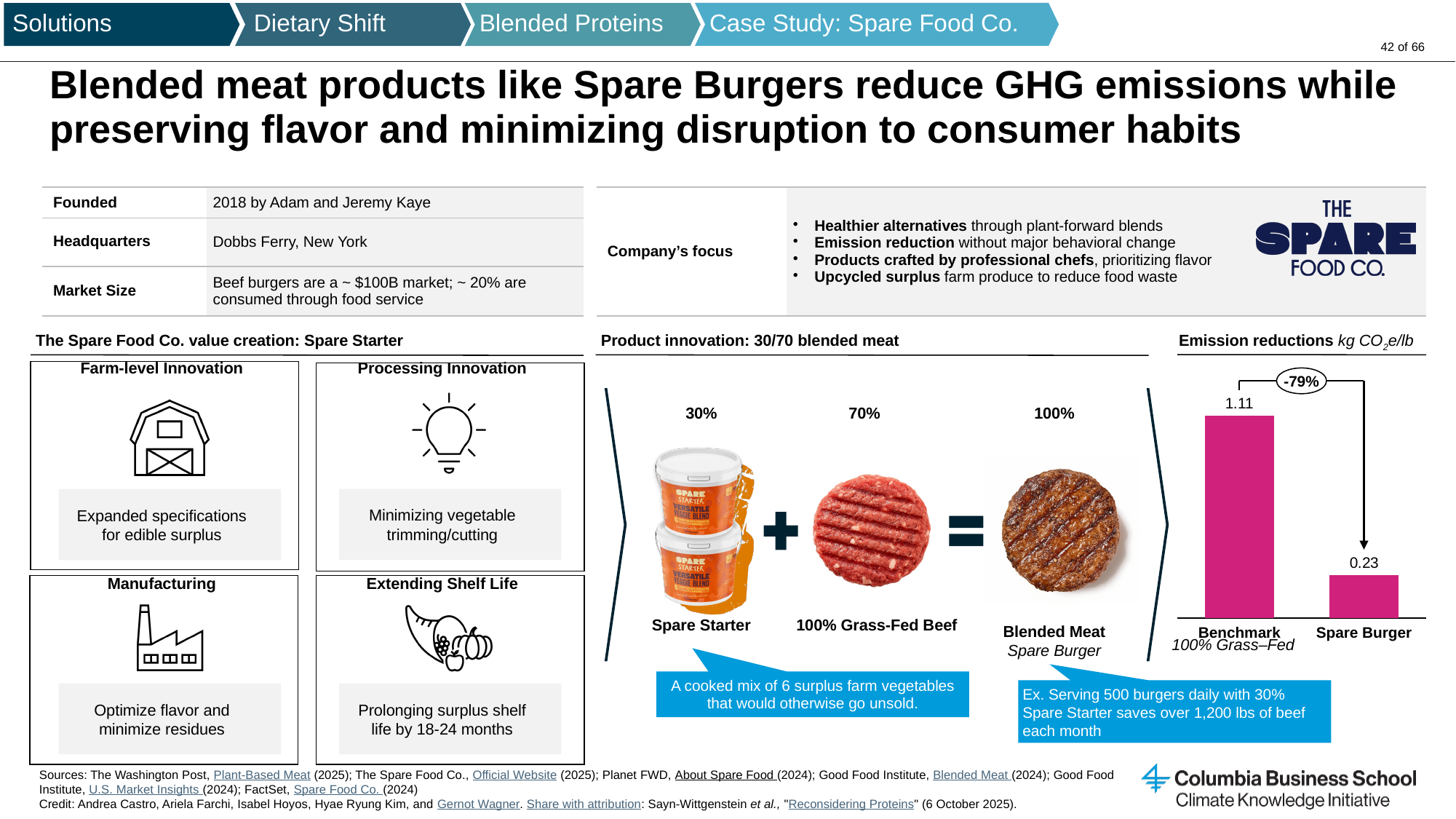
In the Emission reductions chart, what is the value for the Benchmark 100% Grass-Fed bar? 1.11 What unit is shown in the title of the Emission reductions chart? kg CO2e/lb How many bars are plotted in the Emission reductions chart? 2 In the Emission reductions chart, which category has the highest value? Benchmark 100% Grass-Fed In the Emission reductions chart, do the values rise or fall from the Benchmark bar to the Spare Burger bar? Fall In the Emission reductions chart, what percentage reduction is annotated between the Benchmark and Spare Burger bars? -79% In the Emission reductions chart, which is larger: the value for Benchmark 100% Grass-Fed or for Spare Burger? Benchmark 100% Grass-Fed In the Emission reductions chart, what is the value for Spare Burger? 0.23 In the Emission reductions chart, which category has the lowest value? Spare Burger What kind of chart is the Emission reductions chart? Bar chart In the Emission reductions chart, what is the difference between the Benchmark 100% Grass-Fed value and the Spare Burger value? 0.88